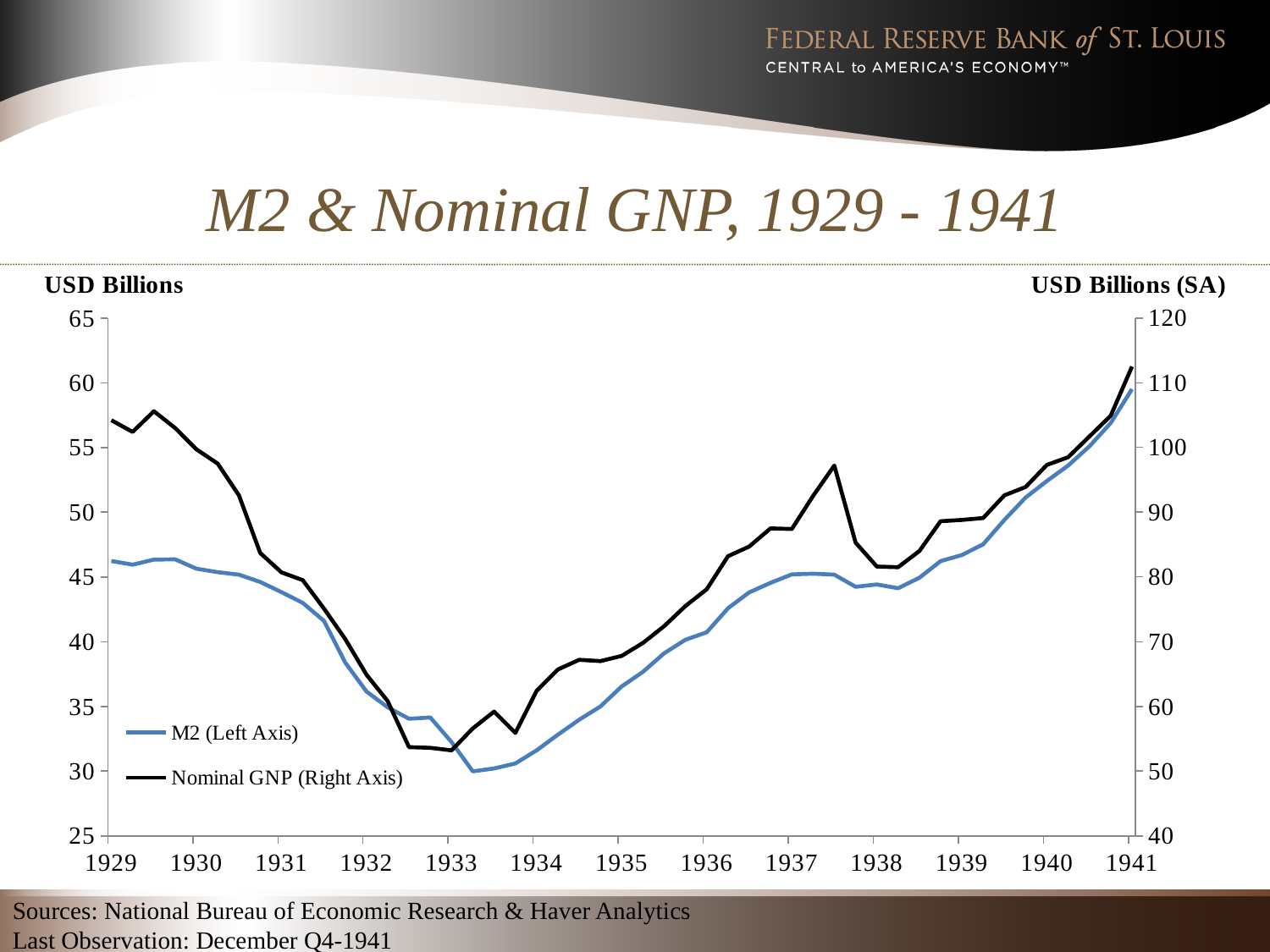
Is the value of Nominal GNP at the start of 1929 greater or less than 100? greater Is the value of M2 at the start of 1933 greater or less than 35? less Does M2 rise or fall between 1929 and 1933? fall How many series does the legend list? 2 Does Nominal GNP rise or fall between 1938 and 1941? rise Is the value of M2 at the start of 1929 greater or less than 40? greater What kind of chart is shown on the slide? Line chart How many years are labelled on the x axis? 13 What is the title of the chart? M2 & Nominal GNP, 1929 - 1941 Which series is plotted against the right axis? Nominal GNP